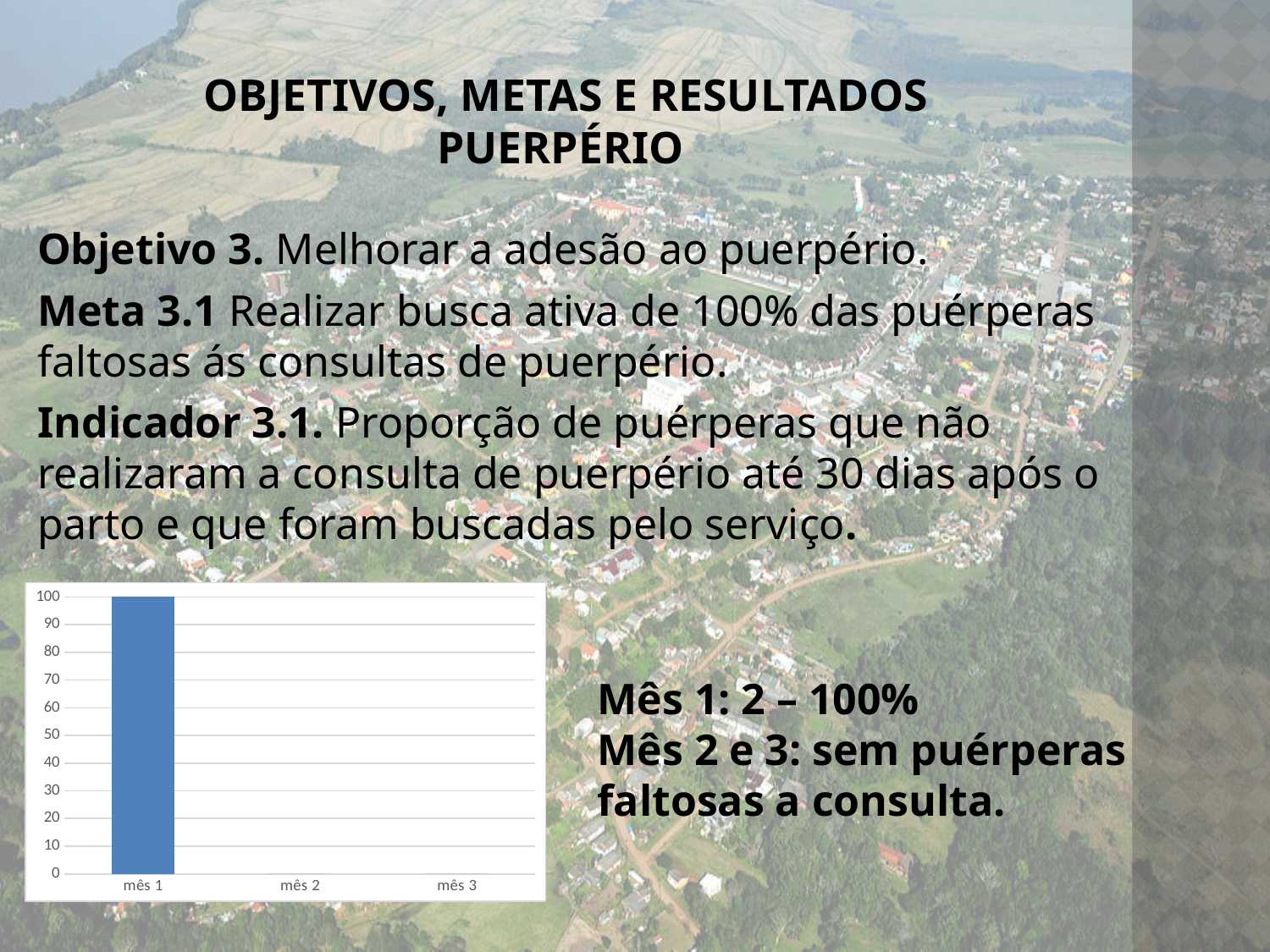
How many categories are shown on the x axis of the chart? 3 What is the label of the last category on the x axis? mês 3 What value does the bar for mês 1 reach on the y axis? 100 Is the value for mês 1 greater or less than 50? greater Which categories on the chart have no visible bar? mês 2 and mês 3 What is the label of the first category on the x axis? mês 1 Which category has the highest bar in the chart? mês 1 Which is larger, the bar for mês 1 or the bar for mês 2? mês 1 What kind of chart is shown on the slide? bar chart What is the highest value shown on the y axis of the chart? 100